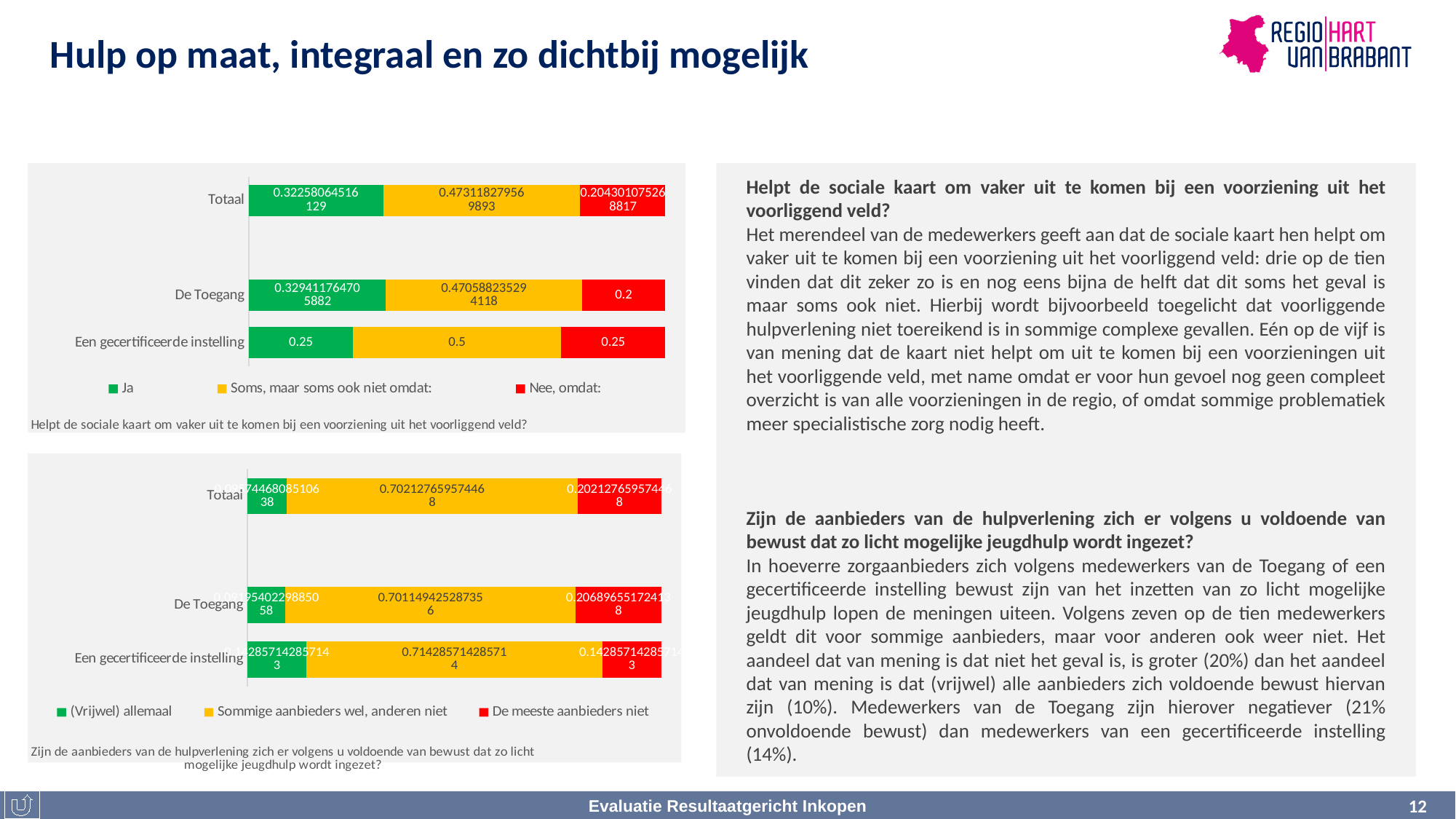
In the bottom chart (Zijn de aanbieders...), what is the value for 'Sommige aanbieders wel, anderen niet' for Een gecertificeerde instelling? 0.714285714285714 In the top chart (Helpt de sociale kaart...), what is the value for 'Ja' for Een gecertificeerde instelling? 0.25 In the bottom chart (Zijn de aanbieders...), which colour represents 'De meeste aanbieders niet'? Red In the top chart (Helpt de sociale kaart...), what is the value for 'Nee, omdat:' for De Toegang? 0.2 In the bottom chart (Zijn de aanbieders...), how many categories are shown? 3 What type of chart is the bottom chart (Zijn de aanbieders...)? Stacked bar chart In the top chart (Helpt de sociale kaart...), what is the value for 'Soms, maar soms ook niet omdat:' for Een gecertificeerde instelling? 0.5 In the top chart (Helpt de sociale kaart...), what is the difference between the 'Soms, maar soms ook niet omdat:' and 'Nee, omdat:' values for Een gecertificeerde instelling? 0.25 In the top chart (Helpt de sociale kaart...), how many series does the legend list? 3 In the top chart (Helpt de sociale kaart...), what is the value for 'Soms, maar soms ook niet omdat:' for Totaal? 0.473118279569893 In the bottom chart (Zijn de aanbieders...), what is the value for 'Sommige aanbieders wel, anderen niet' for Totaal? 0.702127659574468 In the top chart (Helpt de sociale kaart...), which category has the highest value for 'Soms, maar soms ook niet omdat:'? Een gecertificeerde instelling